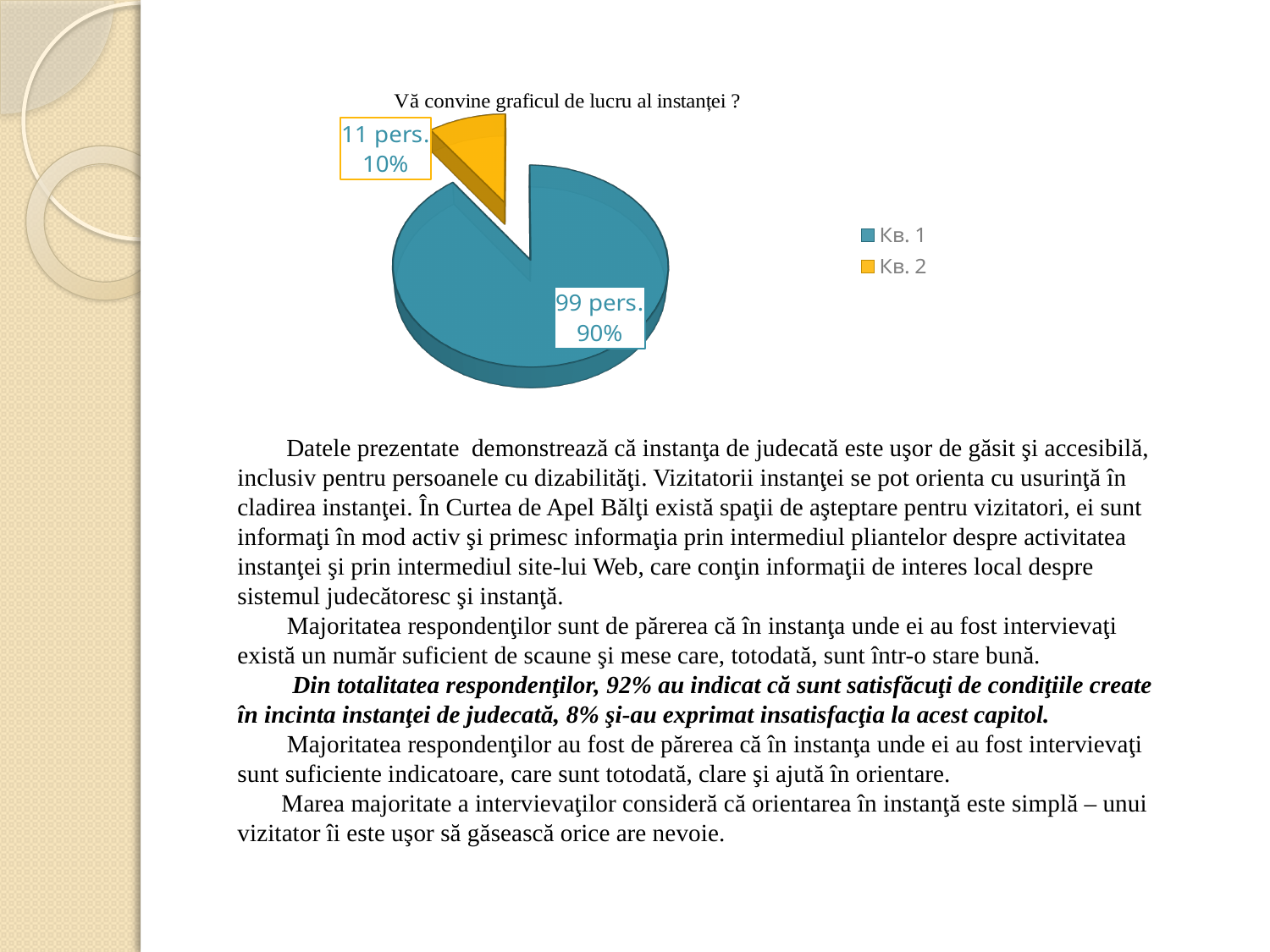
What is the title of the chart? Vă convine graficul de lucru al instanţei ? How many entries does the legend list? 2 What percentage share does the Кв. 1 slice represent? 90% What is the difference in persons between the Кв. 1 and Кв. 2 slices? 88 Which slice is the largest? Кв. 1 How many persons does the Кв. 1 slice represent? 99 pers. Which slice is the smallest? Кв. 2 What percentage share does the Кв. 2 slice represent? 10% What colour is the Кв. 2 slice? yellow How many slices does the pie chart have? 2 How many persons does the Кв. 2 slice represent? 11 pers. What kind of chart is shown on the slide? pie chart